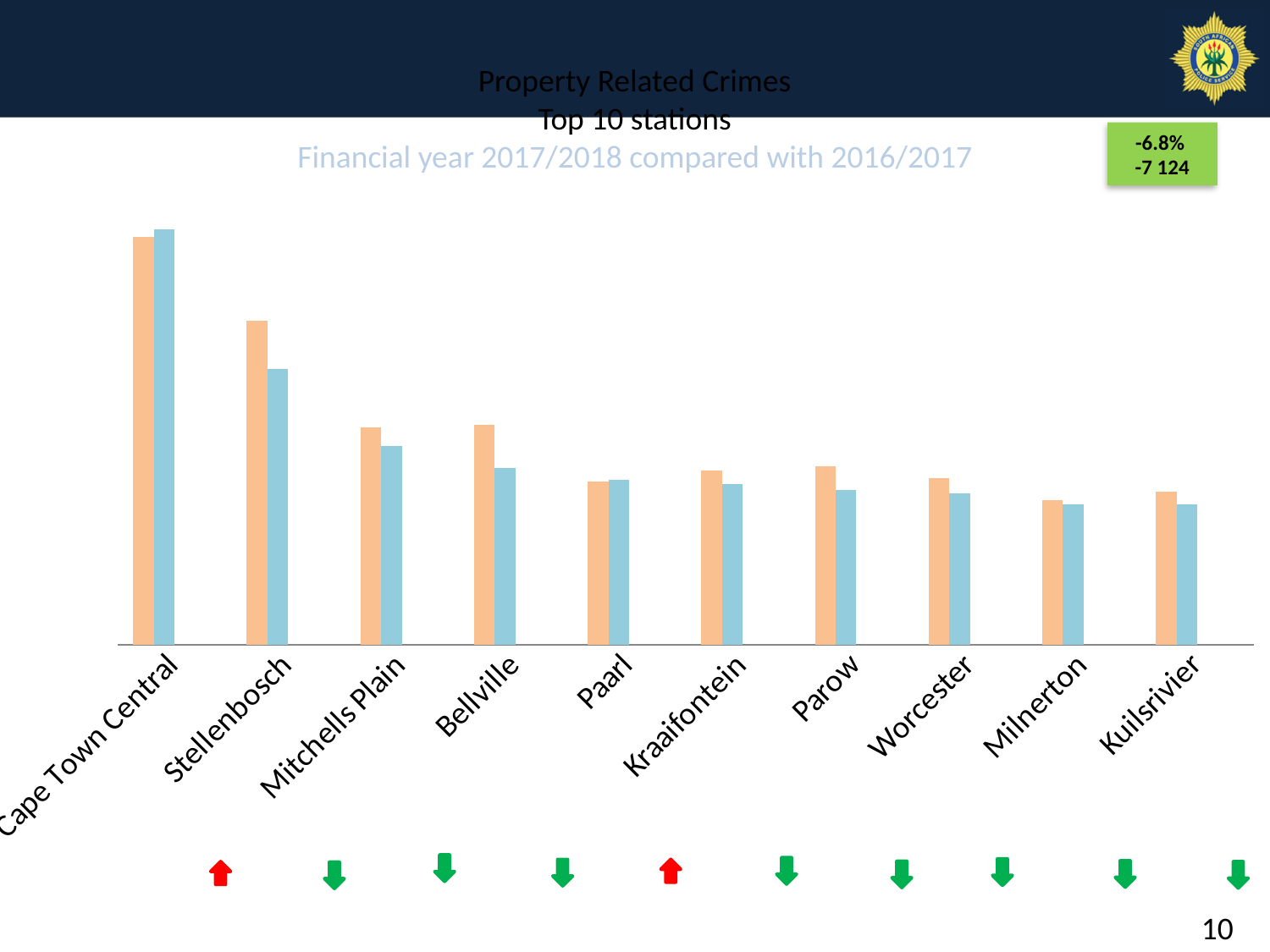
What is the first line of the chart's title? Property Related Crimes Do the bar heights generally rise or fall moving from left to right across the stations? fall How many bars are plotted for each station? 2 Which station has taller bars, Stellenbosch or Mitchells Plain? Stellenbosch What kind of chart is shown on the slide? bar chart For Bellville, which bar is taller, the orange one or the blue one? the orange one For Cape Town Central, which bar is taller, the orange one or the blue one? the blue one Which station has the tallest bars in the chart? Cape Town Central How many red upward arrows appear below the chart? 2 How many stations are shown on the x axis of the chart? 10